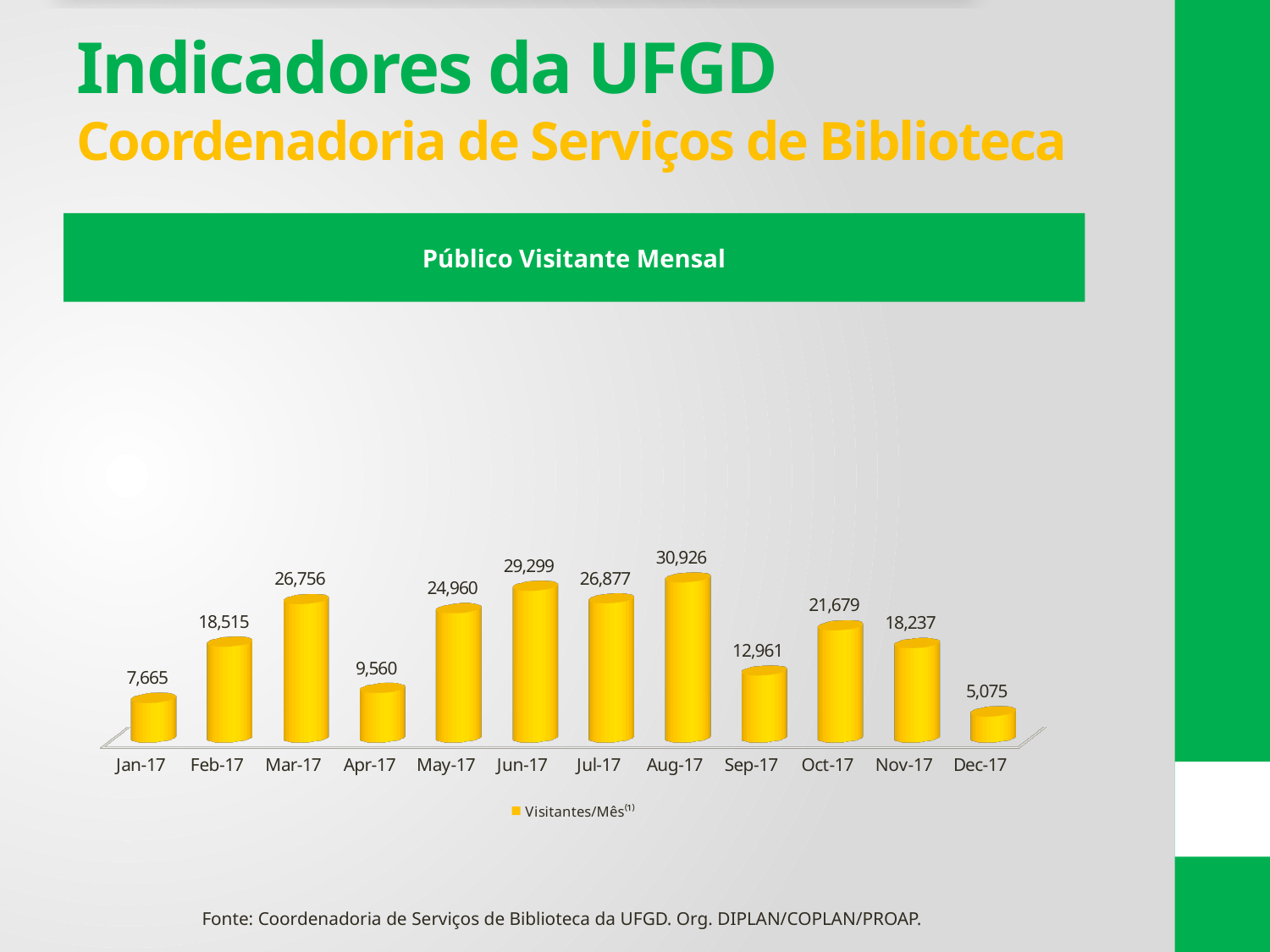
What is the value for Aug-17? 30,926 What kind of chart is shown on the slide? Bar chart What is the difference between the values for Aug-17 and Dec-17? 25,851 Which month has the lowest number of visitors? Dec-17 What is the title of the chart? Público Visitante Mensal What is the value for Oct-17? 21,679 Which is larger, the value for Jun-17 or the value for Jul-17? Jun-17 What is the value for Apr-17? 9,560 How many months are shown on the chart? 12 How many series does the legend list? 1 Which month has the highest number of visitors? Aug-17 What is the difference between the values for Mar-17 and Feb-17? 8,241